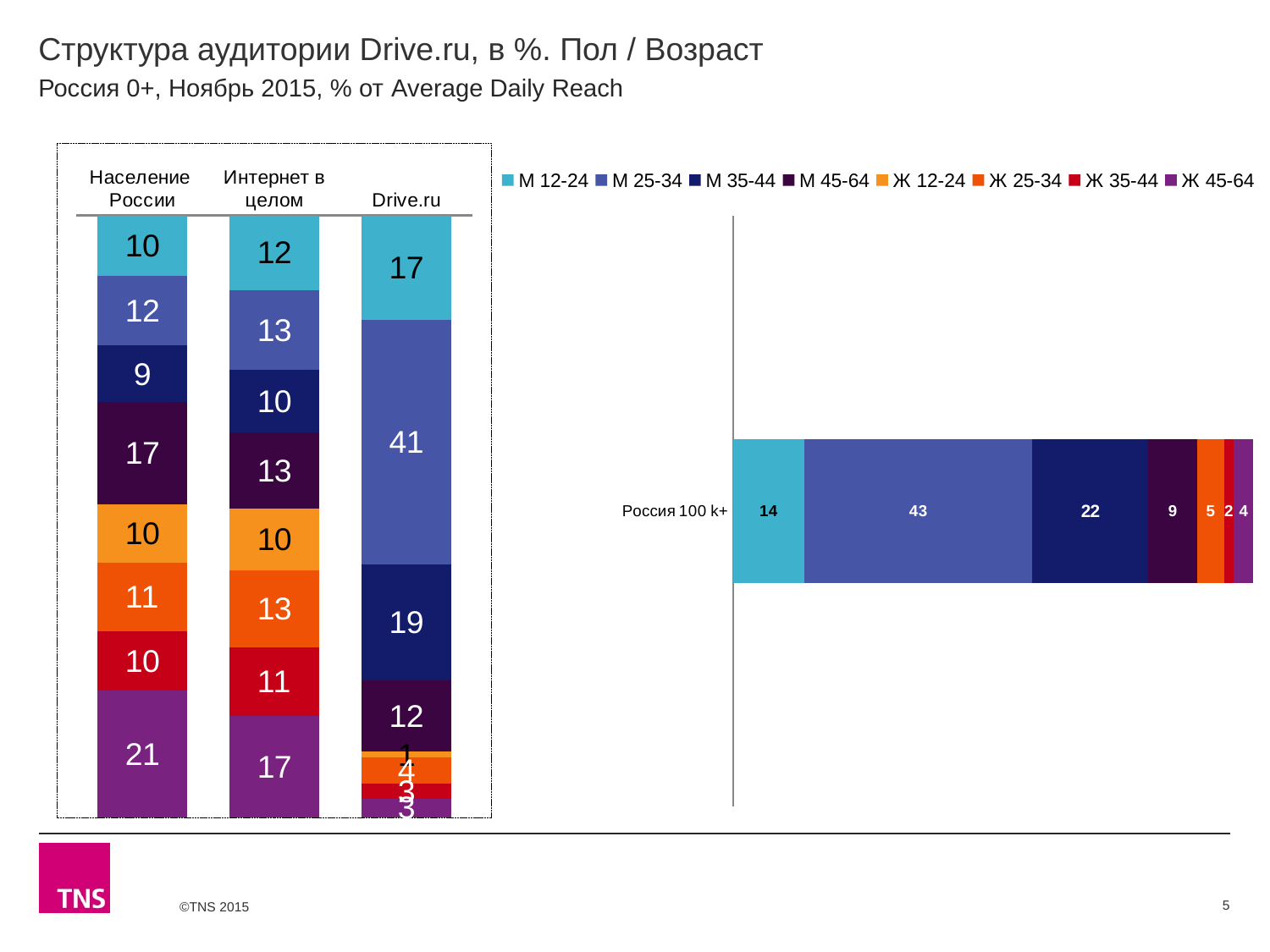
In the right chart (Россия 100 k+), what is the value of the М 25-34 segment? 43 How many bars does the left chart contain? 3 In the left chart, what is the difference between the М 12-24 values for Drive.ru and Население России? 7 In the left chart, which is larger: the М 35-44 value for Drive.ru or for Интернет в целом? Drive.ru What type of chart is the right chart (Россия 100 k+)? Stacked bar chart In the left chart, what is the value of the М 25-34 segment for Drive.ru? 41 In the left chart, which segment is the largest in the Население России bar? Ж 45-64 In the left chart, what is the value of the Ж 45-64 segment for Интернет в целом? 17 In the right chart (Россия 100 k+), which segment is the largest? М 25-34 In the right chart (Россия 100 k+), what is the value of the М 35-44 segment? 22 In the left chart, what is the value of the М 45-64 segment for Население России? 17 How many series does the legend list? 8